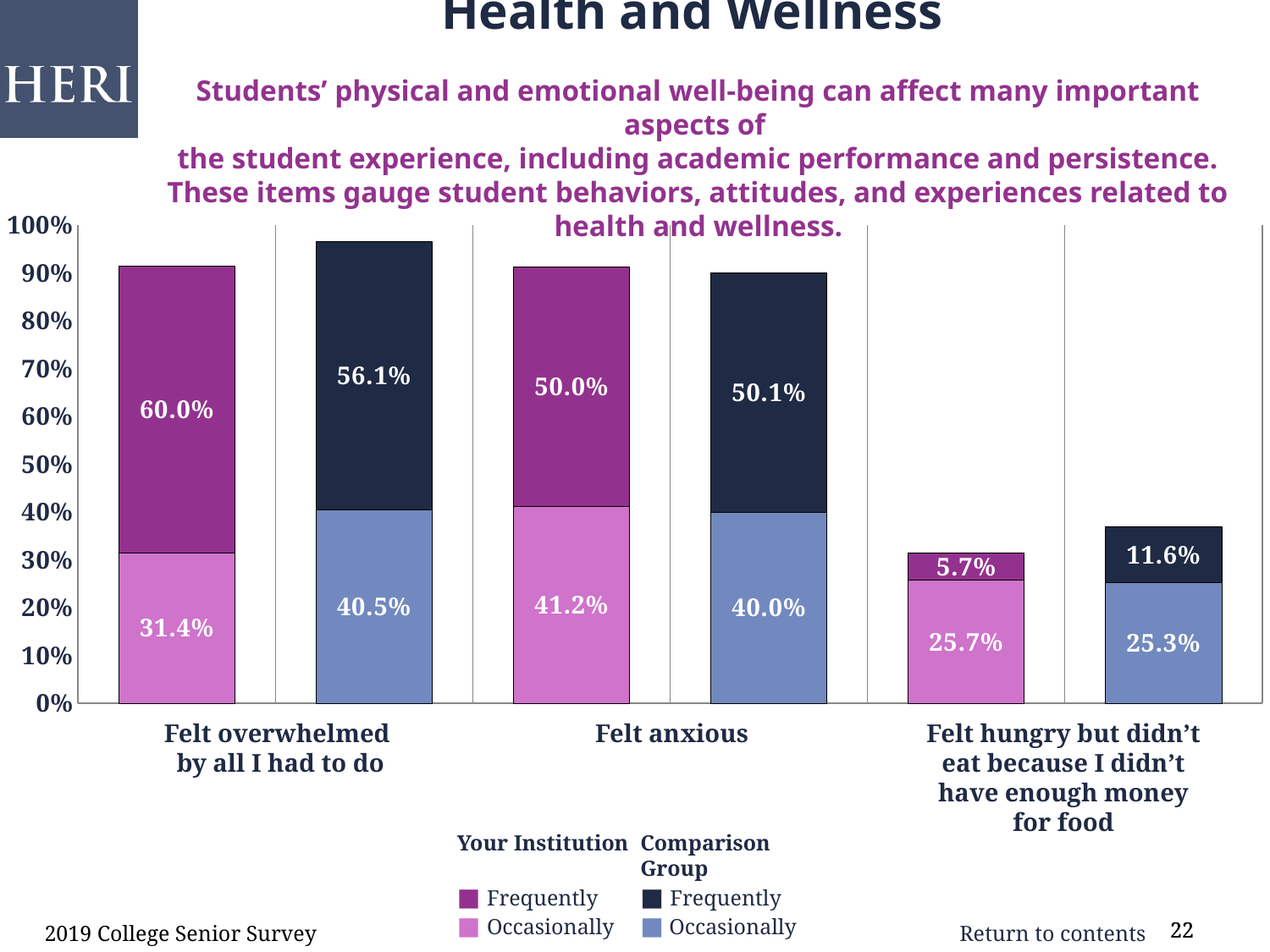
What is the difference between the Comparison Group's and Your Institution's 'Frequently' values for 'Felt hungry but didn't eat because I didn't have enough money for food'? 5.9% What percentage of the Comparison Group reported occasionally feeling anxious? 40.0% How many items (categories) are shown on the x axis of the chart? 3 Which item has the highest 'Frequently' value for Your Institution? Felt overwhelmed by all I had to do What type of chart is shown on the slide? Stacked bar chart How many entries does the chart's legend list? 4 What percentage of students at Your Institution reported frequently feeling overwhelmed by all they had to do? 60.0% What percentage of students at Your Institution reported frequently feeling hungry but not eating because they didn't have enough money for food? 5.7% What is the total percentage (Frequently plus Occasionally) for Your Institution's bar for 'Felt overwhelmed by all I had to do'? 91.4% Which is larger: the 'Occasionally' value for Your Institution or for the Comparison Group for 'Felt overwhelmed by all I had to do'? Comparison Group What is the total percentage (Frequently plus Occasionally) for the Comparison Group's bar for 'Felt hungry but didn't eat because I didn't have enough money for food'? 36.9% Across all three items, which 'Frequently' value is the lowest? 5.7% (Your Institution, Felt hungry but didn't eat because I didn't have enough money for food)